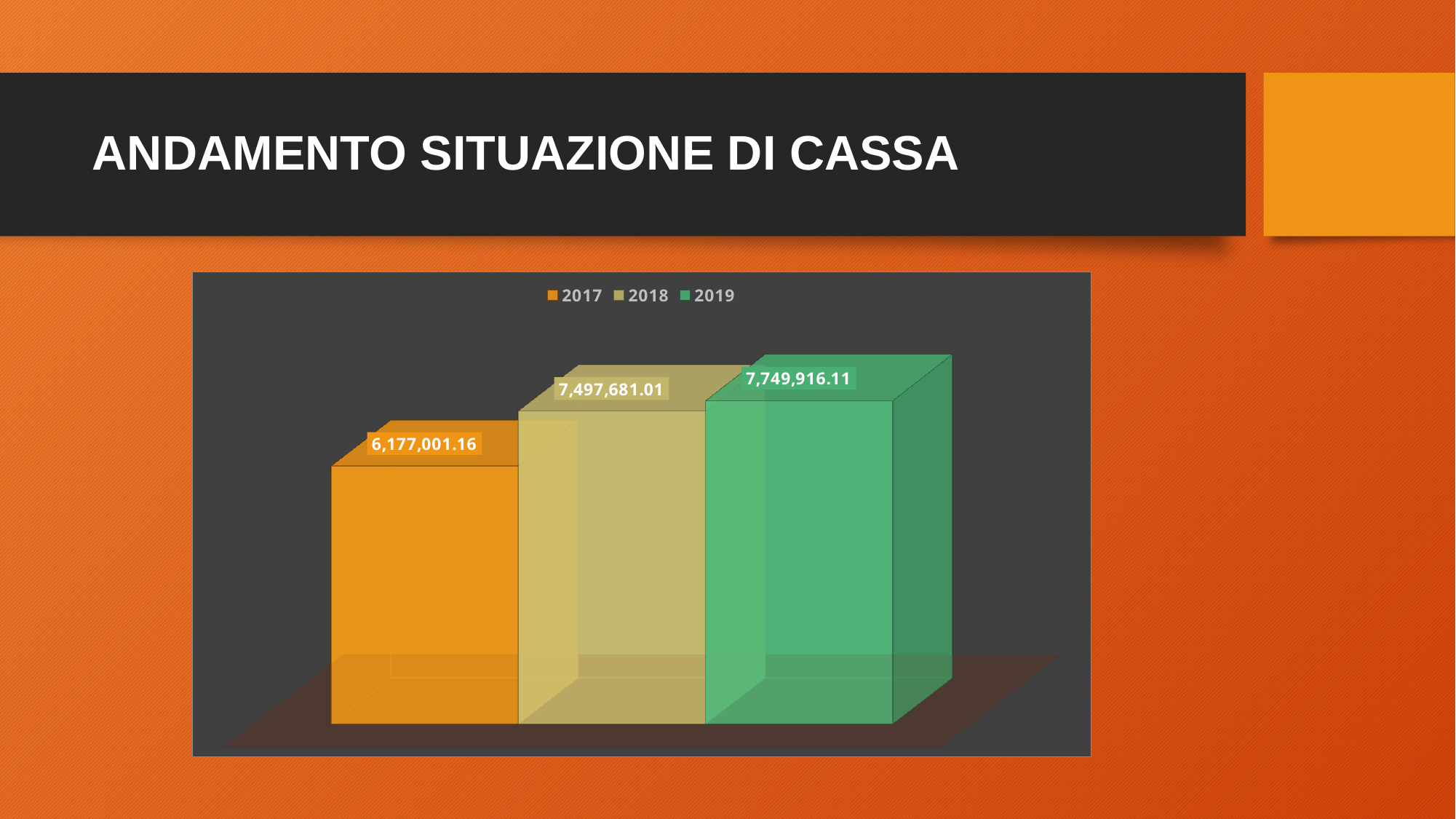
Do the values rise or fall from 2017 to 2019? Rise Which year has the lowest value? 2017 What is the value shown for 2018? 7,497,681.01 What is the value shown for 2017? 6,177,001.16 What kind of chart is shown on the slide? Bar chart What is the difference between the 2019 value and the 2018 value? 252,235.10 What is the difference between the 2018 value and the 2017 value? 1,320,679.85 Which is larger, the value for 2017 or the value for 2018? 2018 What is the value shown for 2019? 7,749,916.11 How many series does the legend list? 3 Which year has the highest value? 2019 What is the difference between the 2019 value and the 2017 value? 1,572,914.95